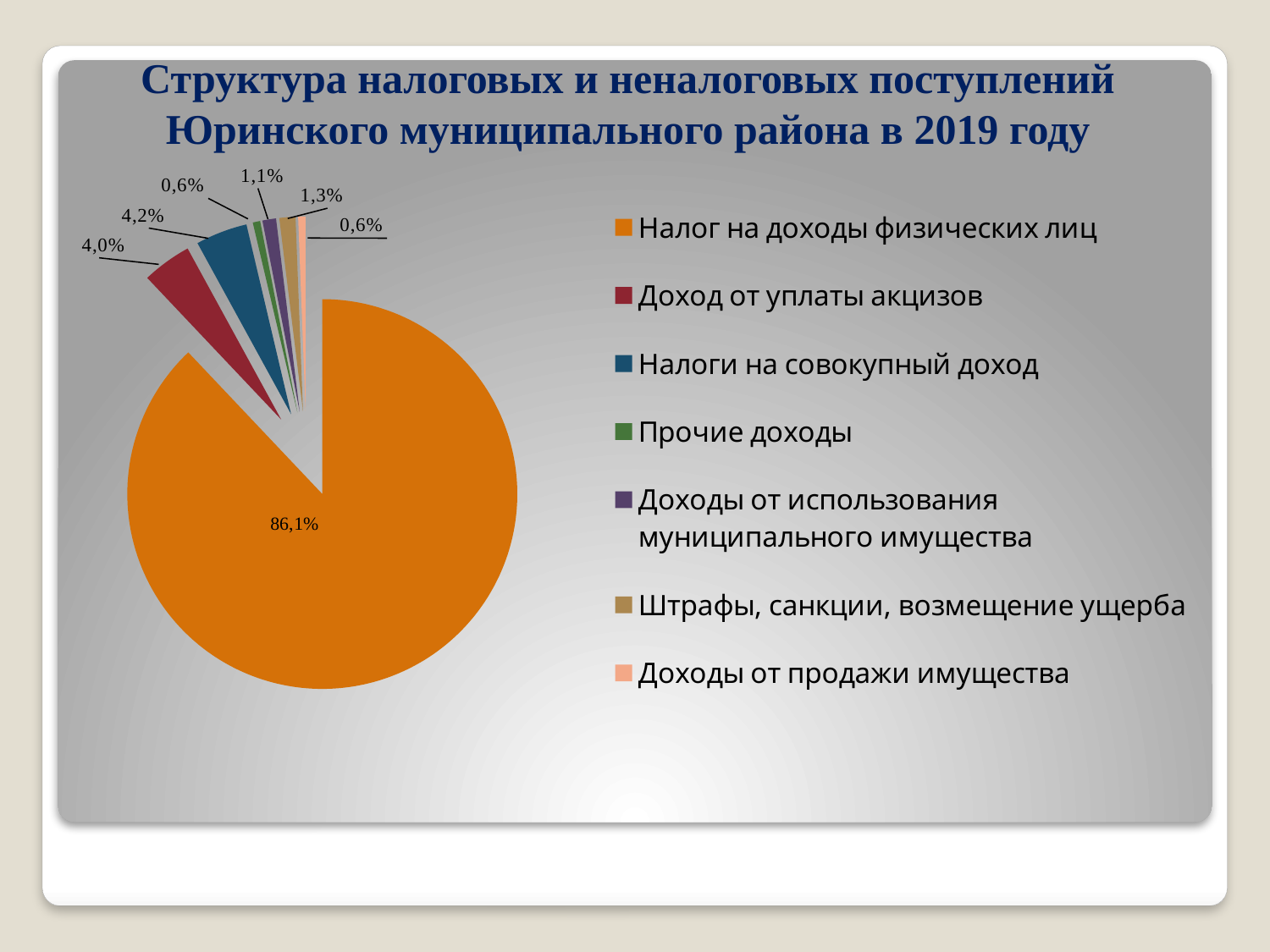
What is the value shown for "Штрафы, санкции, возмещение ущерба"? 1,3% What share of the pie does "Налог на доходы физических лиц" have? 86,1% What is the value shown for "Доходы от использования муниципального имущества"? 1,1% Which is larger: "Налоги на совокупный доход" or "Доход от уплаты акцизов"? Налоги на совокупный доход What is the value shown for "Налоги на совокупный доход"? 4,2% How many categories does the pie chart have? 7 What kind of chart is shown on the slide? pie chart What is the value shown for "Доход от уплаты акцизов"? 4,0% What is the value shown for "Прочие доходы"? 0,6% Which category has the largest share of the pie? Налог на доходы физических лиц What colour is the slice for "Доход от уплаты акцизов"? red What is the difference between the shares of "Налоги на совокупный доход" and "Доход от уплаты акцизов"? 0,2%